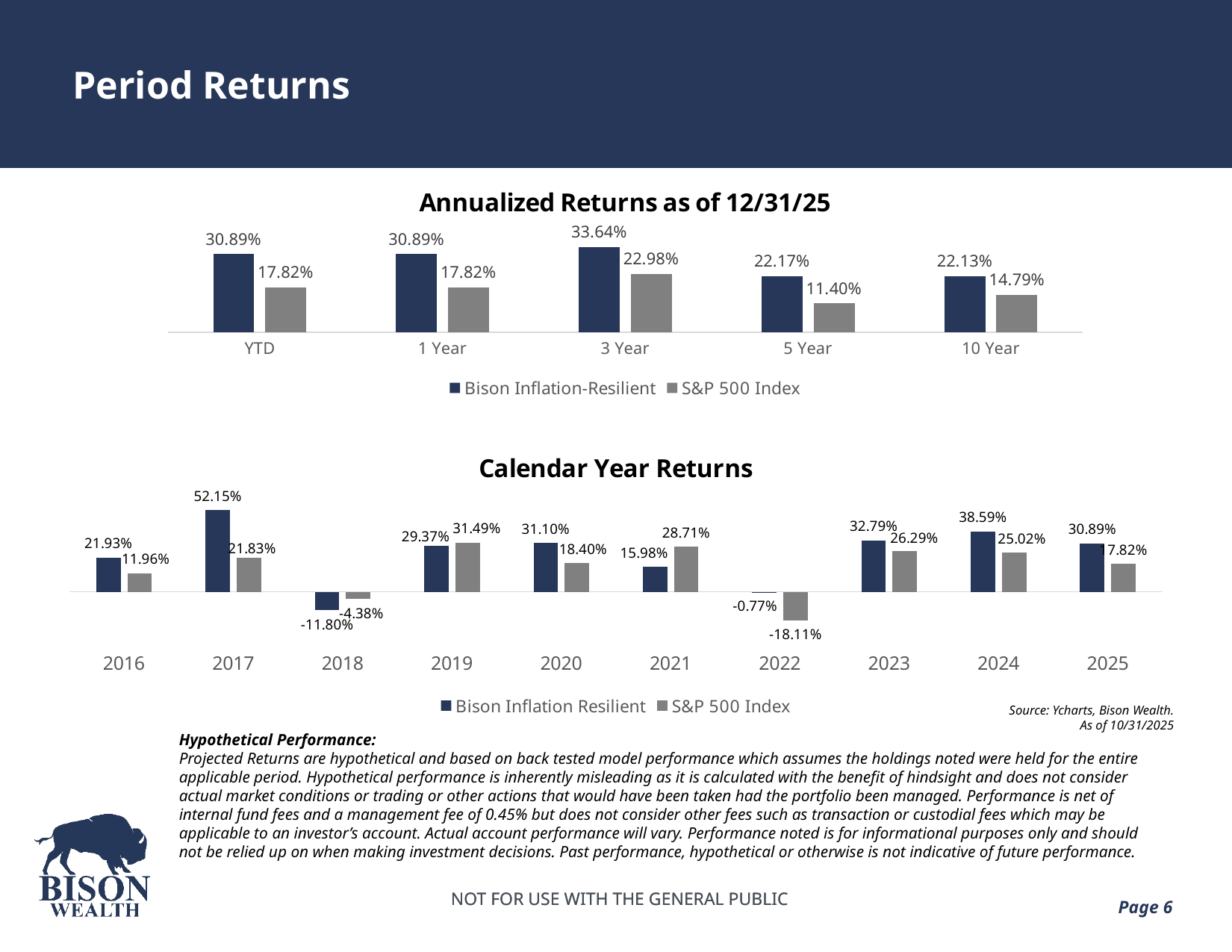
In the Calendar Year Returns chart, what is the 2017 value for Bison Inflation Resilient? 52.15% How many series does the legend of the Calendar Year Returns chart list? 2 In the Annualized Returns as of 12/31/25 chart, what is the difference between the Bison Inflation-Resilient and S&P 500 Index values for 3 Year? 10.66 percentage points In the Calendar Year Returns chart, which year has the lowest Bison Inflation Resilient value? 2018 In the Calendar Year Returns chart, what is the 2022 value for the S&P 500 Index? -18.11% How many periods are shown on the x axis of the Annualized Returns as of 12/31/25 chart? 5 In the Calendar Year Returns chart, which is larger for 2021, Bison Inflation Resilient or the S&P 500 Index? S&P 500 Index In the Annualized Returns as of 12/31/25 chart, which period has the lowest S&P 500 Index value? 5 Year In the Annualized Returns as of 12/31/25 chart, which period has the highest Bison Inflation-Resilient value? 3 Year In the Annualized Returns as of 12/31/25 chart, what is the 3 Year value for Bison Inflation-Resilient? 33.64% How many years are shown on the x axis of the Calendar Year Returns chart? 10 In the Annualized Returns as of 12/31/25 chart, what is the 5 Year value for the S&P 500 Index? 11.40%